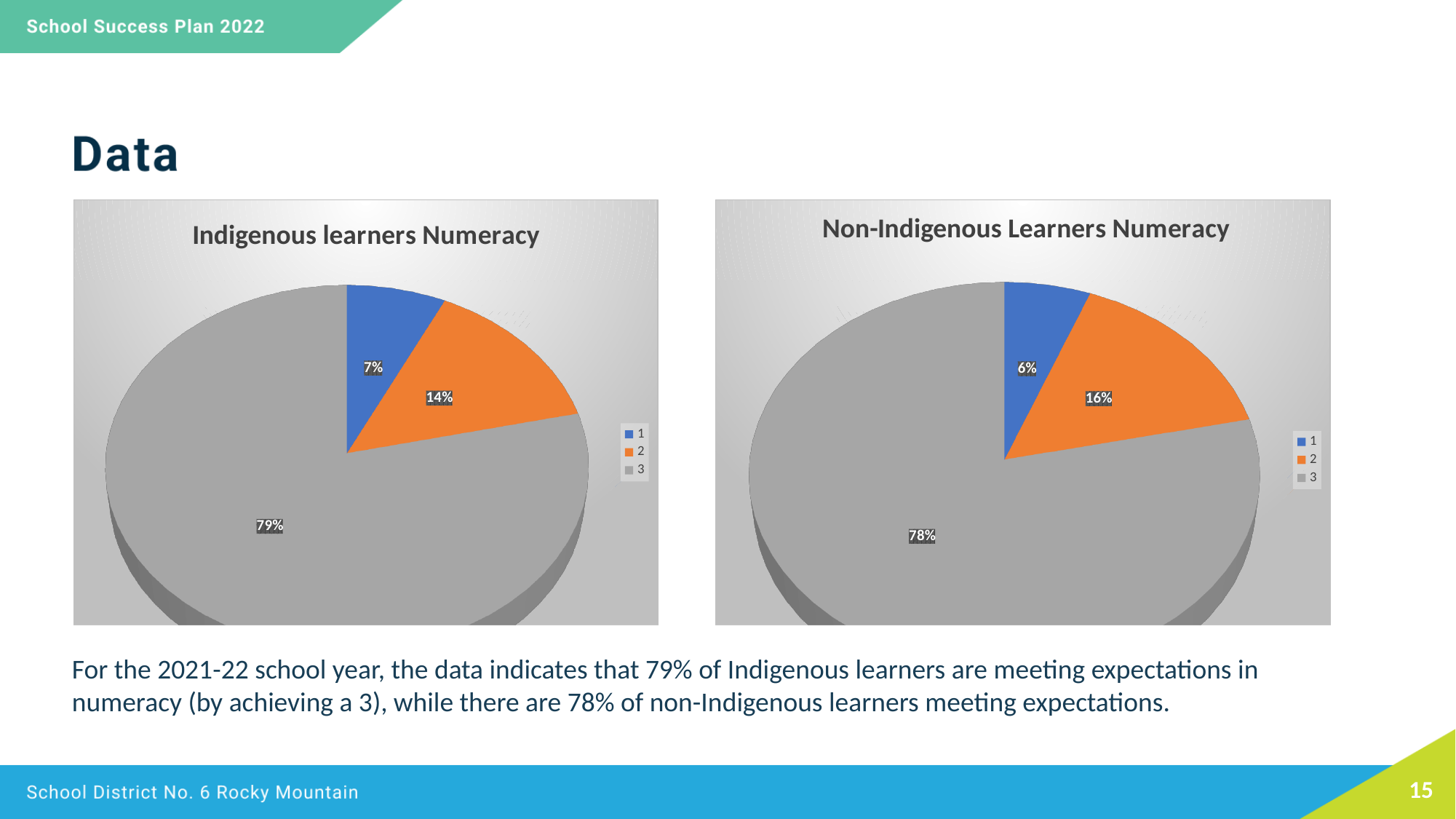
In the 'Indigenous learners Numeracy' chart, what is the value for category 2? 14% In the 'Indigenous learners Numeracy' chart, what share of the pie does category 3 take? 79% In the 'Indigenous learners Numeracy' chart, what is the value for category 1? 7% What type of chart is the 'Indigenous learners Numeracy' chart? Pie chart In the 'Non-Indigenous Learners Numeracy' chart, which category has the largest slice? 3 In the 'Non-Indigenous Learners Numeracy' chart, what is the difference between the values for category 2 and category 1? 10% Which is larger: category 2 in the 'Indigenous learners Numeracy' chart or category 2 in the 'Non-Indigenous Learners Numeracy' chart? Non-Indigenous Learners Numeracy How many categories does the legend of the 'Non-Indigenous Learners Numeracy' chart list? 3 In the 'Non-Indigenous Learners Numeracy' chart, what share of the pie does category 3 take? 78% In the 'Non-Indigenous Learners Numeracy' chart, what is the value for category 2? 16% In the 'Indigenous learners Numeracy' chart, which category has the smallest slice? 1 In the 'Non-Indigenous Learners Numeracy' chart, what is the value for category 1? 6%